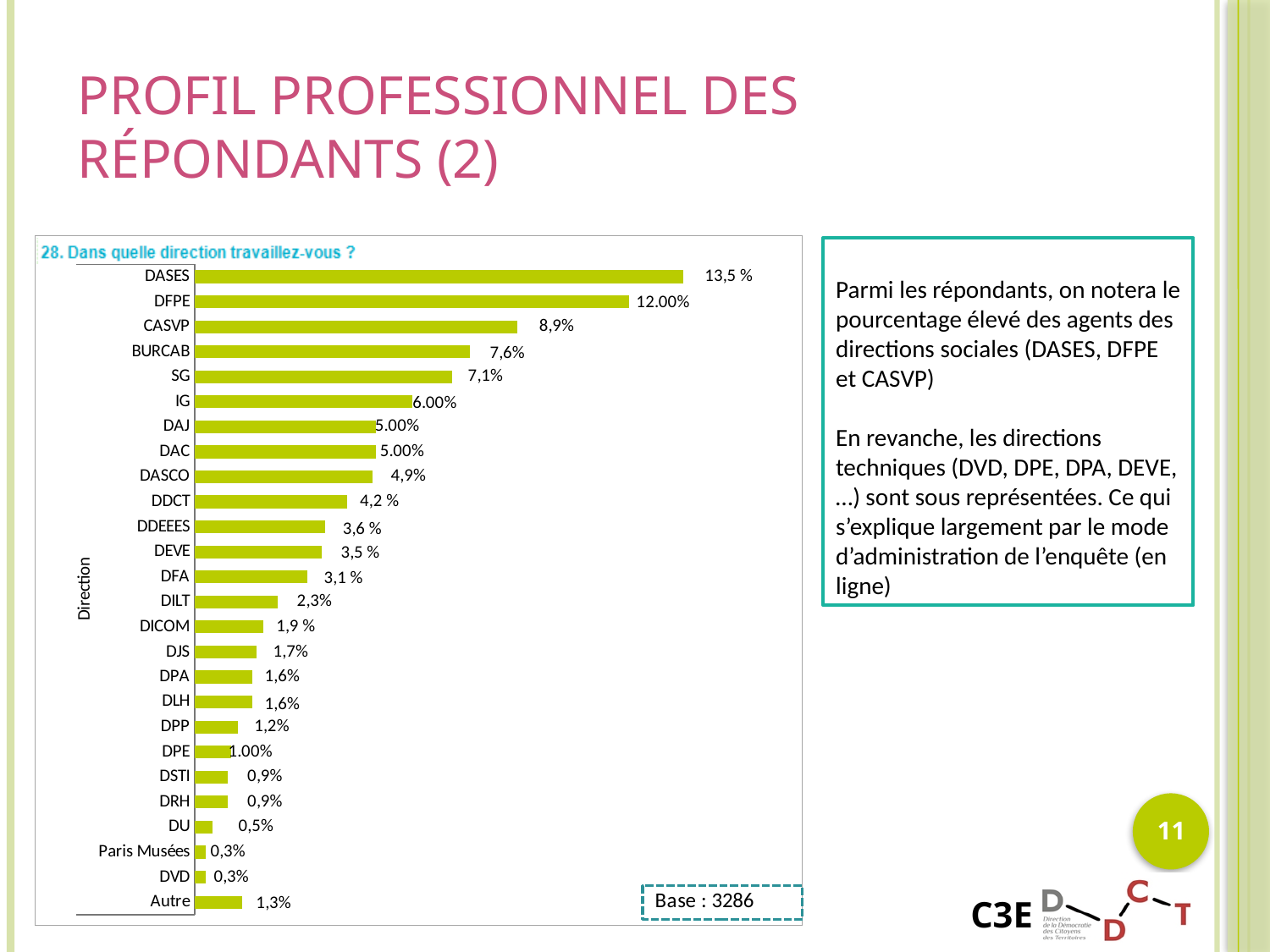
What is the value shown for DEVE? 3,5 % What is the difference in percentage points between DASES (13,5 %) and DFPE (12.00%)? 1,5 What is the value shown for DVD? 0,3% What is the value shown for CASVP? 8,9% What is the title of the chart? 28. Dans quelle direction travaillez-vous ? How many directions (categories) are listed in the chart? 26 Which is larger, the value for SG or the value for IG? SG What is the value shown for DASES? 13,5 % Which direction has the highest value in the chart? DASES What is the value shown for Autre? 1,3% What type of chart is shown on the slide? bar chart Which is larger, the value for DILT or the value for DICOM? DILT